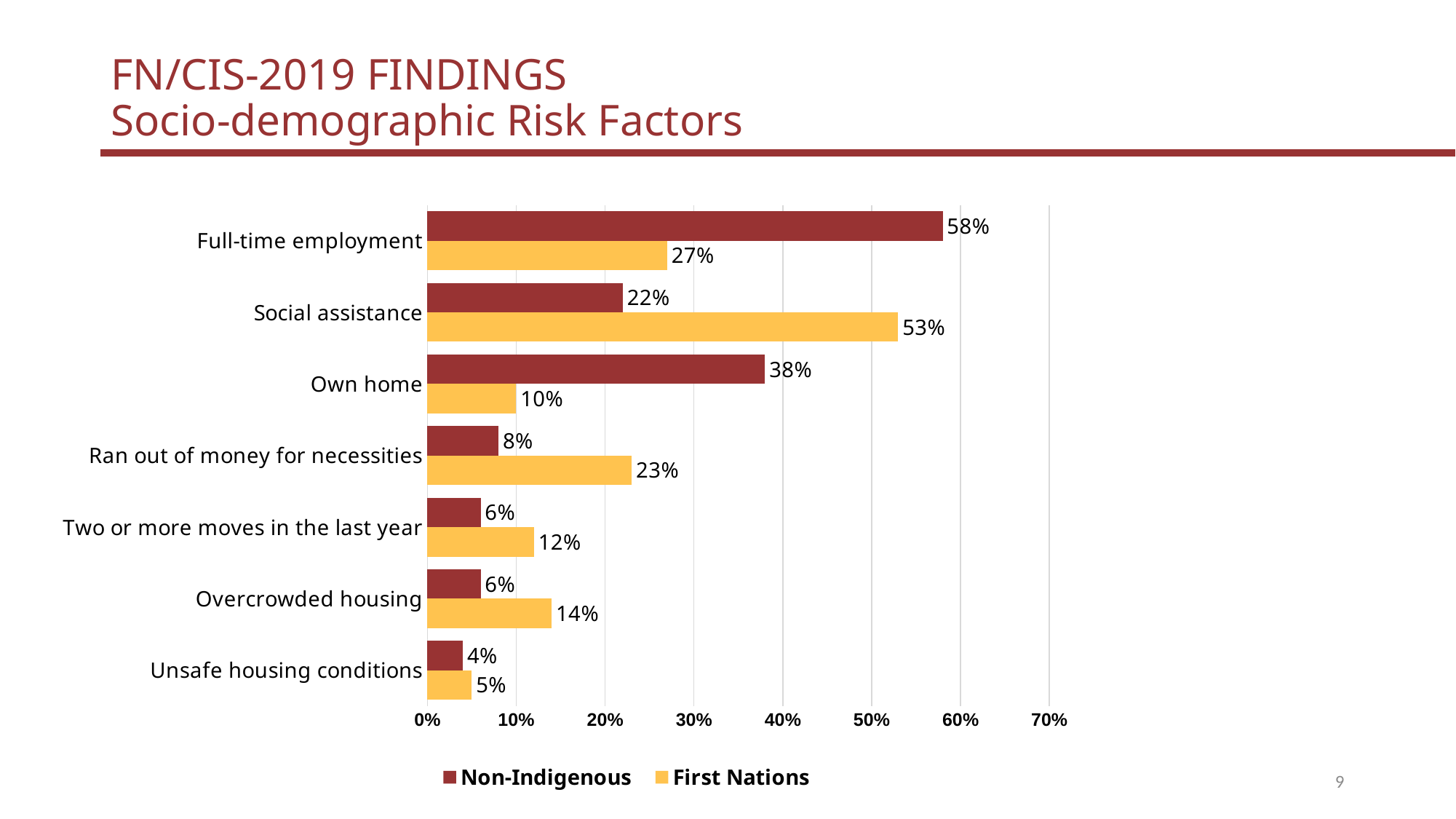
Which category has the lowest First Nations value? Unsafe housing conditions How many series does the legend list? 2 What kind of chart is shown on the slide? Bar chart Is the First Nations value for Social assistance greater or less than 50%? greater Which colour represents the First Nations series? Yellow What is the First Nations value for Overcrowded housing? 14% Which is larger for Ran out of money for necessities: the Non-Indigenous value or the First Nations value? First Nations What is the First Nations value for Social assistance? 53% How many categories are shown on the chart? 7 What is the Non-Indigenous value for Own home? 38% Which category has the highest Non-Indigenous value? Full-time employment What is the difference between the Non-Indigenous and First Nations values for Full-time employment? 31%